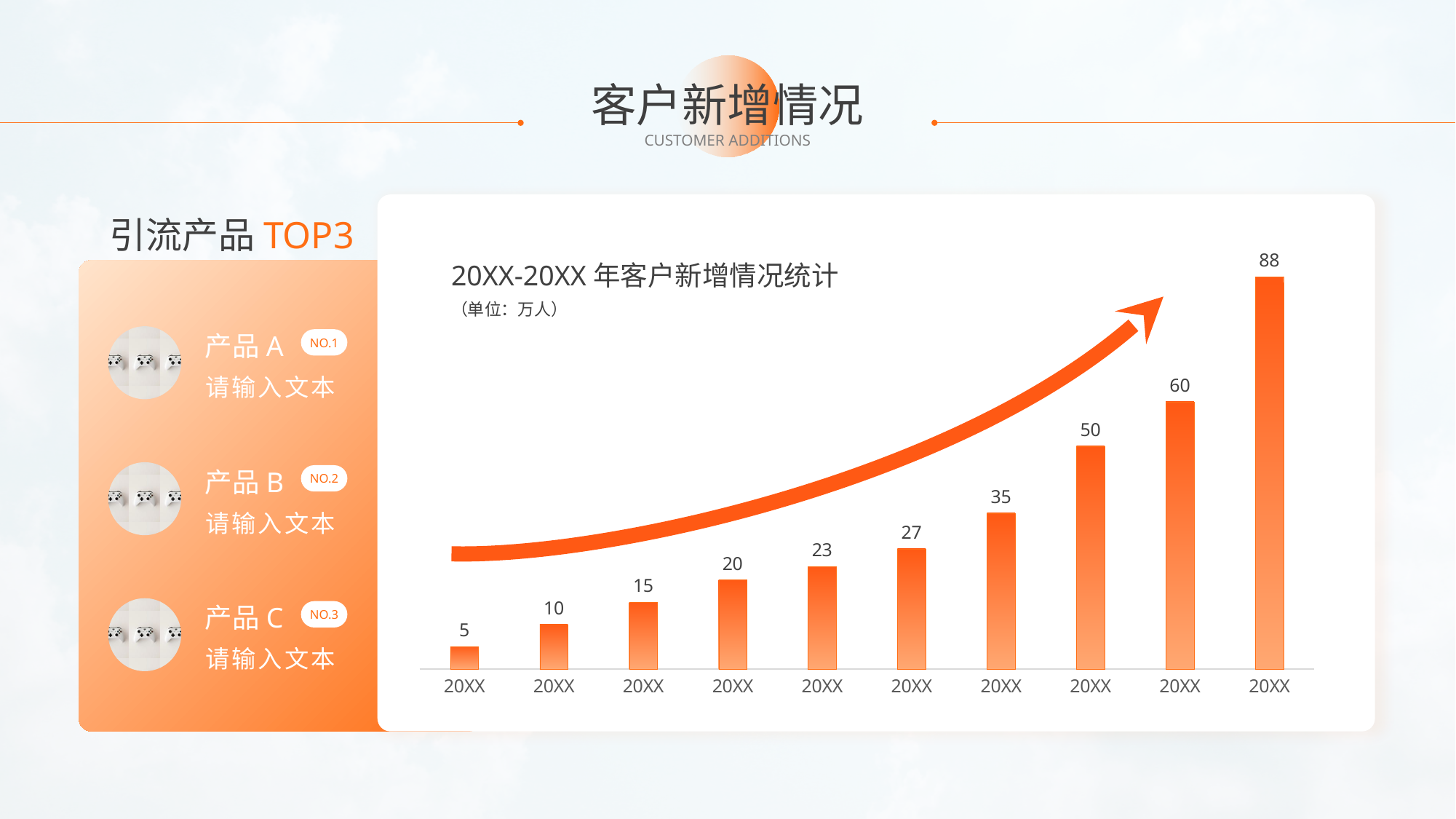
Do the values rise or fall from left to right along the x axis? rise What is the value of the fifth bar from the left? 23 What is the lowest value shown in the chart? 5 What type of chart is shown on the slide? bar chart What is the highest value shown in the chart? 88 What is the value of the first (leftmost) bar in the chart? 5 What is the difference between the rightmost bar and the leftmost bar? 83 What is the title of the chart? 20XX-20XX 年客户新增情况统计 What unit is stated for the chart values? 万人 What is the difference between the ninth bar (60) and the eighth bar (50)? 10 What is the value of the last (rightmost) bar in the chart? 88 How many bars are plotted in the chart? 10